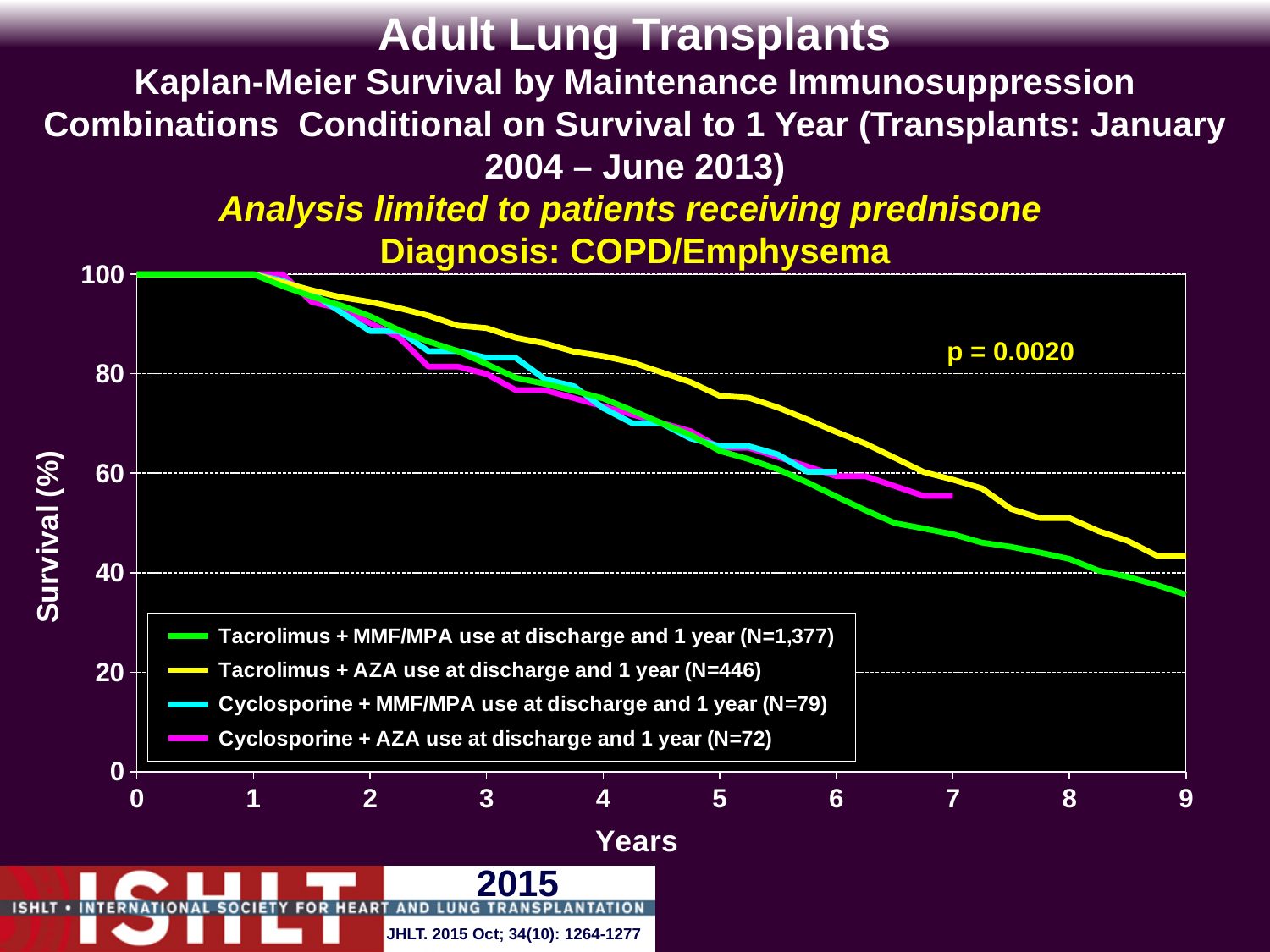
How many series does the legend list? 4 What p-value is printed on the chart? p = 0.0020 What kind of chart is shown on the slide? Line chart At 8 years, which group has higher survival: Tacrolimus + AZA or Tacrolimus + MMF/MPA? Tacrolimus + AZA What is the N for the Tacrolimus + MMF/MPA use at discharge and 1 year group in the legend? N=1,377 Which group has the highest survival at 9 years? Tacrolimus + AZA use at discharge and 1 year Is the survival for Tacrolimus + AZA use at discharge and 1 year at 5 years greater or less than 60? greater At 6 years, which group has higher survival: Tacrolimus + MMF/MPA or Tacrolimus + AZA? Tacrolimus + AZA Is the survival for Tacrolimus + AZA use at discharge and 1 year at 9 years greater or less than 40? greater Is the survival for Tacrolimus + MMF/MPA use at discharge and 1 year at 4 years greater or less than 80? less Do the survival curves rise or fall as the years increase? Fall